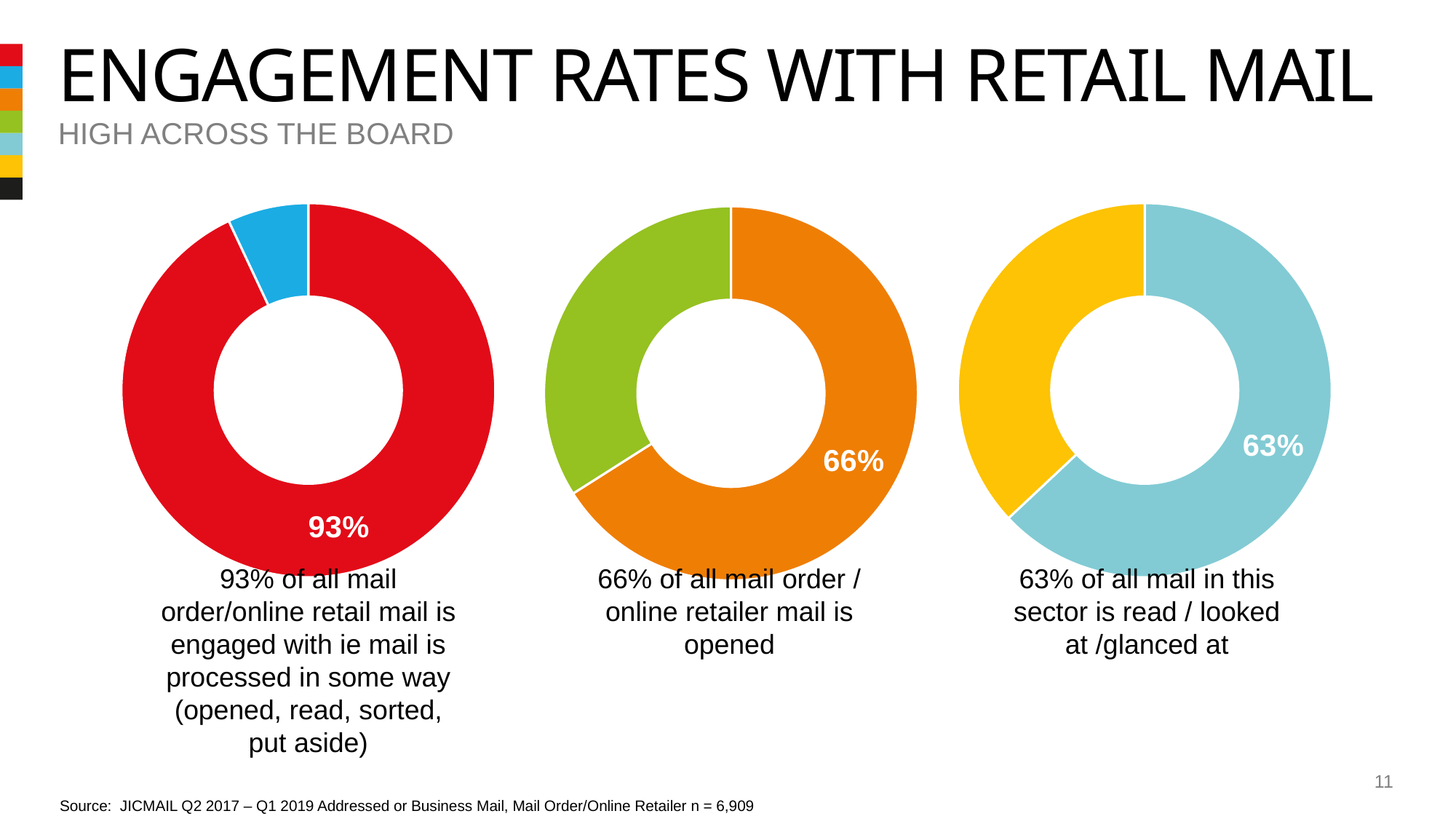
What kind of chart is used for each of the three figures on the slide? Donut (pie) chart What percentage is labelled on the left donut chart (red)? 93% How many donut charts are shown on the slide? 3 Which of the three donut charts shows the lowest labelled percentage? The right chart (63%) In the middle donut chart, which slice is larger, the orange or the green? Orange In the right donut chart, which slice is larger, the light blue or the yellow? Light blue What percentage is labelled on the right donut chart (light blue)? 63% What percentage is labelled on the middle donut chart (orange)? 66% How many slices does the left donut chart have? 2 What colour is the slice labelled 93% in the left donut chart? Red Which of the three donut charts shows the highest labelled percentage? The left chart (93%) What is the difference between the percentage on the left chart and the percentage on the middle chart? 27 percentage points